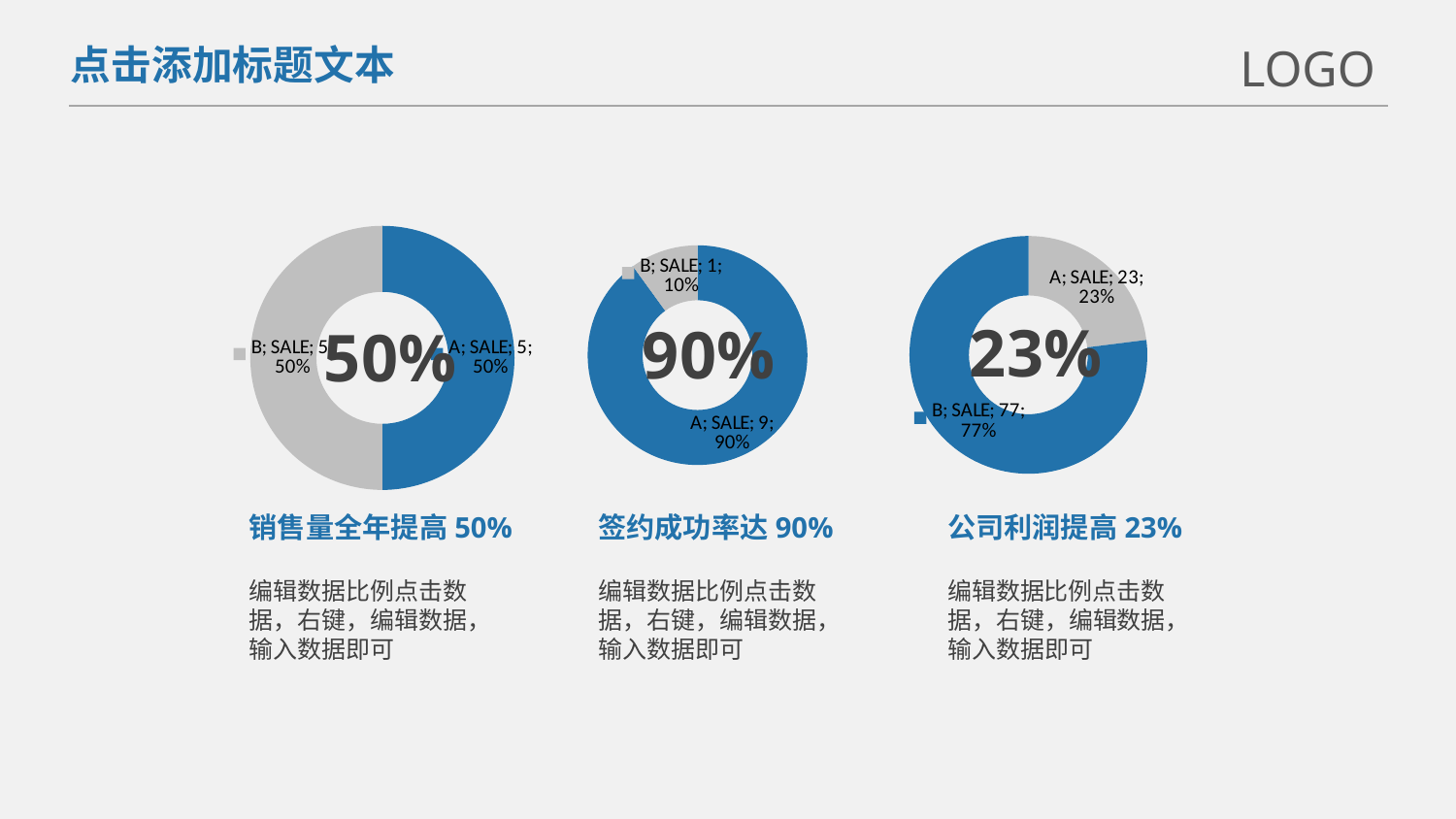
How many slices does the left doughnut chart have? 2 In the right doughnut chart, what is the value of slice B? 77 What large number is printed in the centre of the right doughnut chart? 23% In the left doughnut chart, what percentage does slice A represent? 50% What type of chart is the middle chart on the slide? Doughnut chart In the right doughnut chart, which slice is the largest? B In the right doughnut chart, what is the difference between the values of slice B and slice A? 54 In the middle doughnut chart, which slice is larger, A or B? A In the middle doughnut chart, which slice is the smallest? B In the right doughnut chart, what percentage does slice A represent? 23% In the middle doughnut chart, what is the value of slice A? 9 In the middle doughnut chart, what percentage does slice B represent? 10%